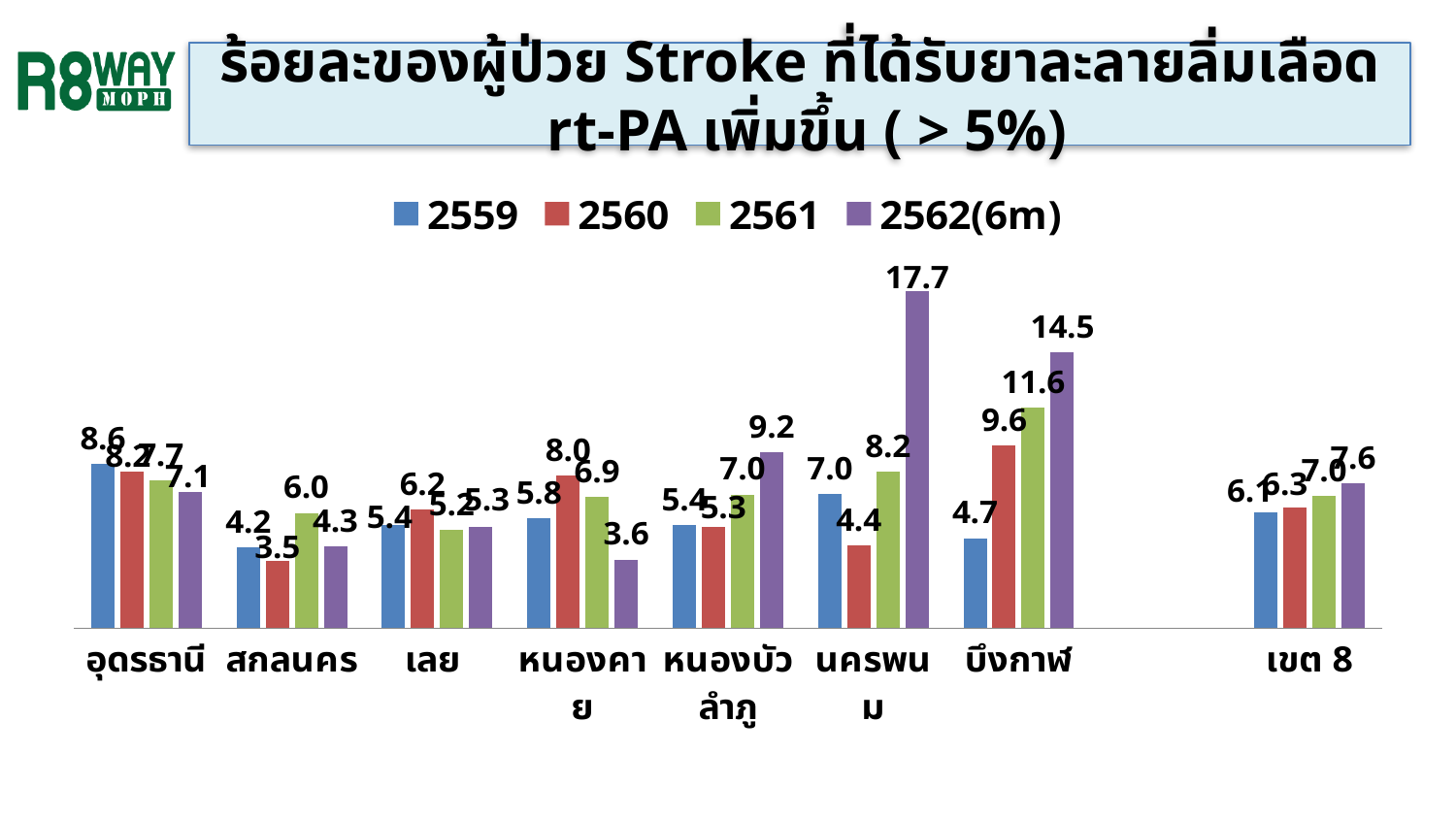
Which category has the lowest value in the 2562(6m) series? หนองคาย What is the value for บึงกาฬ in the 2561 series? 11.6 For เขต 8, do the values rise or fall from 2559 to 2562(6m)? rise How many categories are shown on the x axis? 8 What is the difference between the 2562(6m) value and the 2559 value for บึงกาฬ? 9.8 For หนองคาย, which series has the larger value, 2560 or 2561? 2560 What kind of chart is shown on the slide? bar chart How many series does the legend list? 4 What is the value for นครพนม in the 2562(6m) series? 17.7 Which category has the highest value in the 2562(6m) series? นครพนม What is the value for สกลนคร in the 2561 series? 6.0 What is the difference between the 2562(6m) value and the 2561 value for นครพนม? 9.5